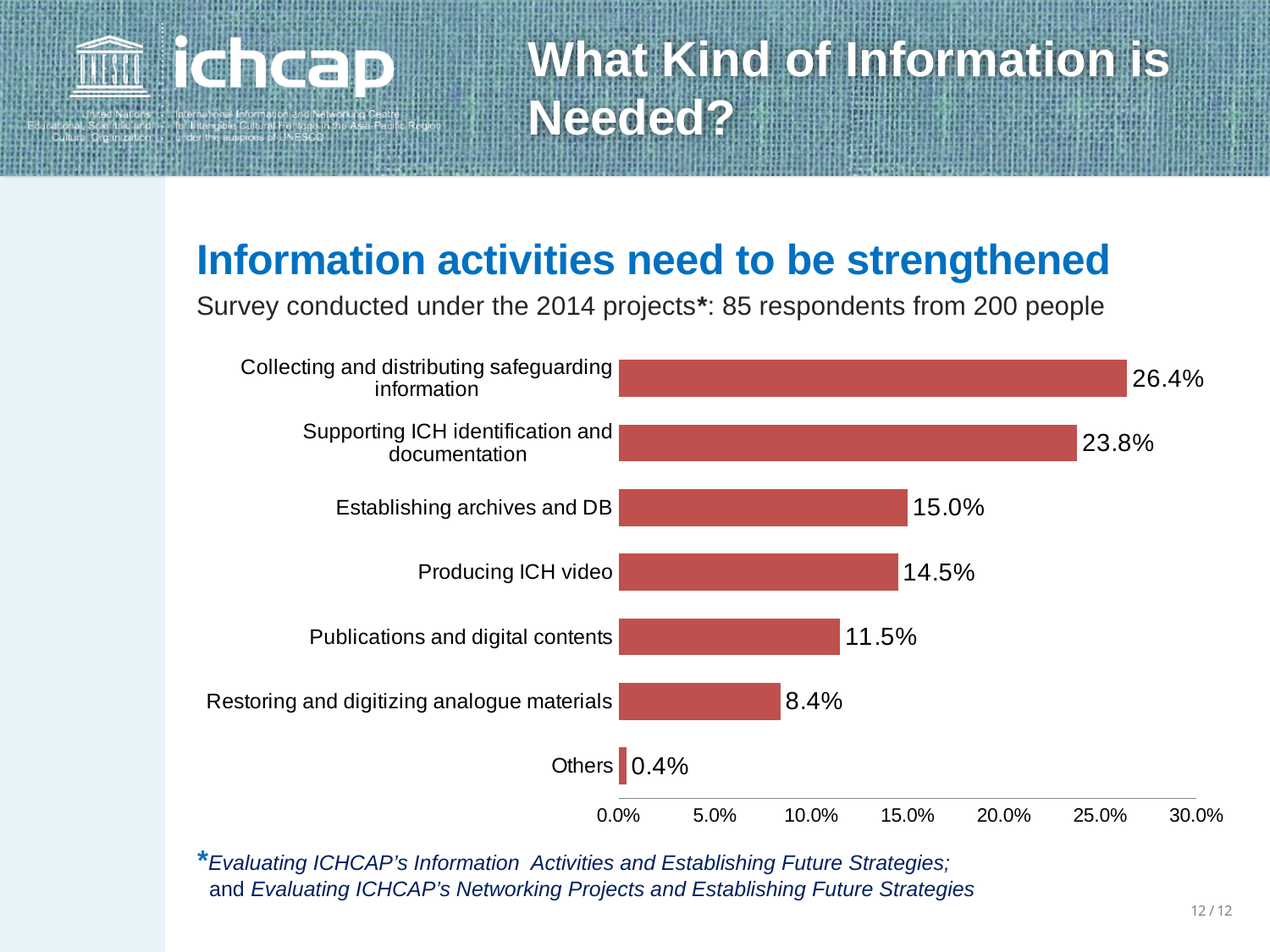
What is the value for Establishing archives and DB? 15.0% Is the value for Supporting ICH identification and documentation greater or less than 20.0%? greater Which category has the lowest value? Others Which category has the highest value? Collecting and distributing safeguarding information Which is larger: the value for Producing ICH video or the value for Publications and digital contents? Producing ICH video What is the maximum value shown on the x axis of the chart? 30.0% What is the value for Publications and digital contents? 11.5% What is the difference between the values for Collecting and distributing safeguarding information and Supporting ICH identification and documentation? 2.6% How many categories are shown in the chart? 7 What is the value for Restoring and digitizing analogue materials? 8.4% What is the difference between the values for Establishing archives and DB and Producing ICH video? 0.5% What kind of chart is shown on the slide? Bar chart